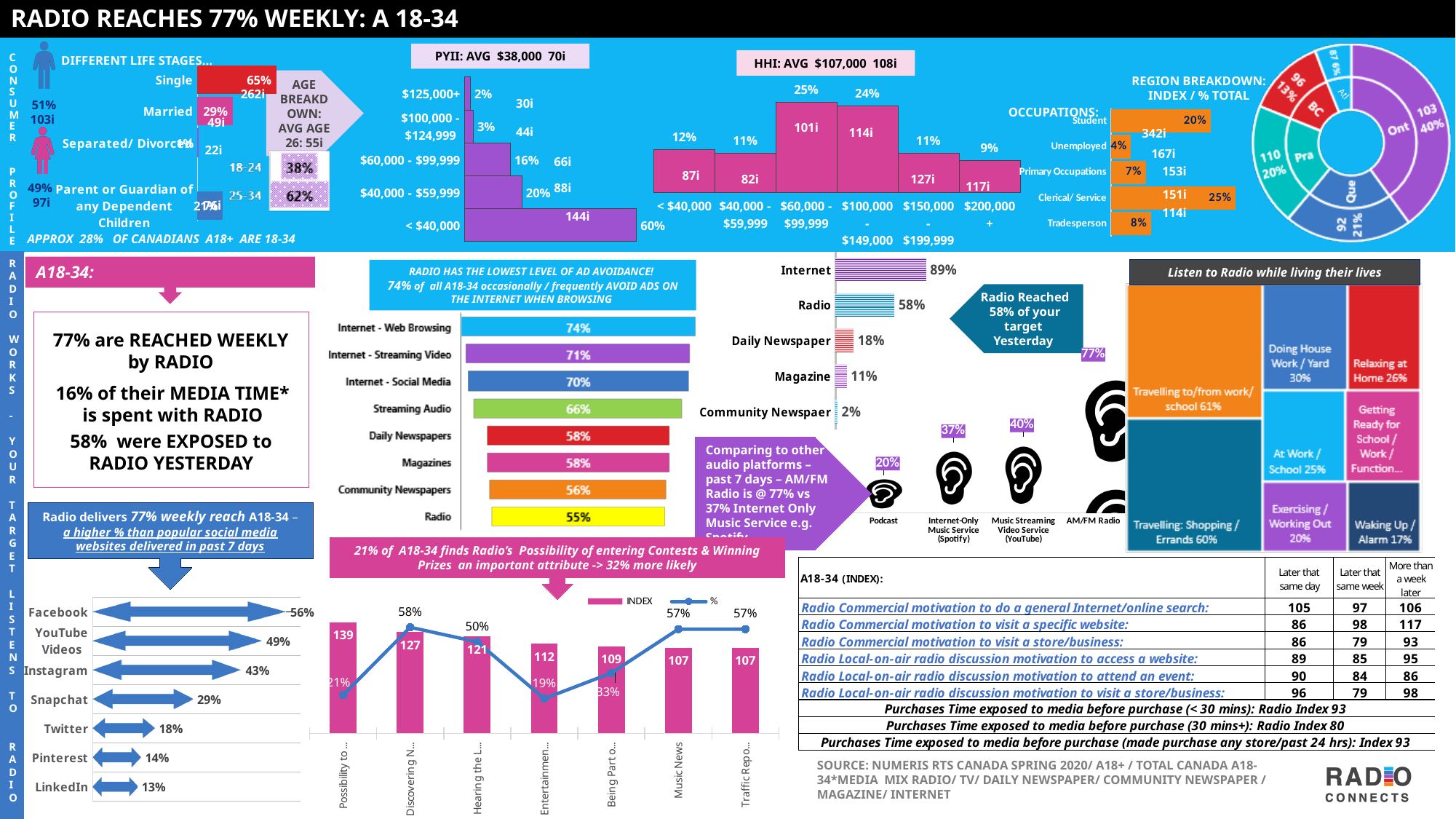
In the audio platforms chart with the ear icons, what is the value for AM/FM Radio? 77% In the media exposed yesterday chart (Internet, Radio, Daily Newspaper, Magazine, Community Newspaper), what is the value for Internet? 89% In the HHI chart at the top of the slide, what percentage is shown for the $60,000 - $99,999 bracket? 25% In the social media chart at the bottom left, what percentage is shown for Snapchat? 29% In the ad avoidance bar chart in the centre of the slide, what percentage is shown for Internet - Web Browsing? 74% In the media exposed yesterday chart, what is the difference between Internet and Radio? 31% In the OCCUPATIONS chart, what index is shown for Student? 342i In the INDEX / % chart at the bottom centre, how many series does the legend list? 2 In the social media chart at the bottom left, which platform has the highest value? Facebook In the ad avoidance bar chart in the centre of the slide, which category has the lowest value? Radio In the ad avoidance bar chart in the centre of the slide, how many categories are listed? 8 In the audio platforms chart with the ear icons, which is larger: Podcast or Internet-Only Music Service (Spotify)? Internet-Only Music Service (Spotify)